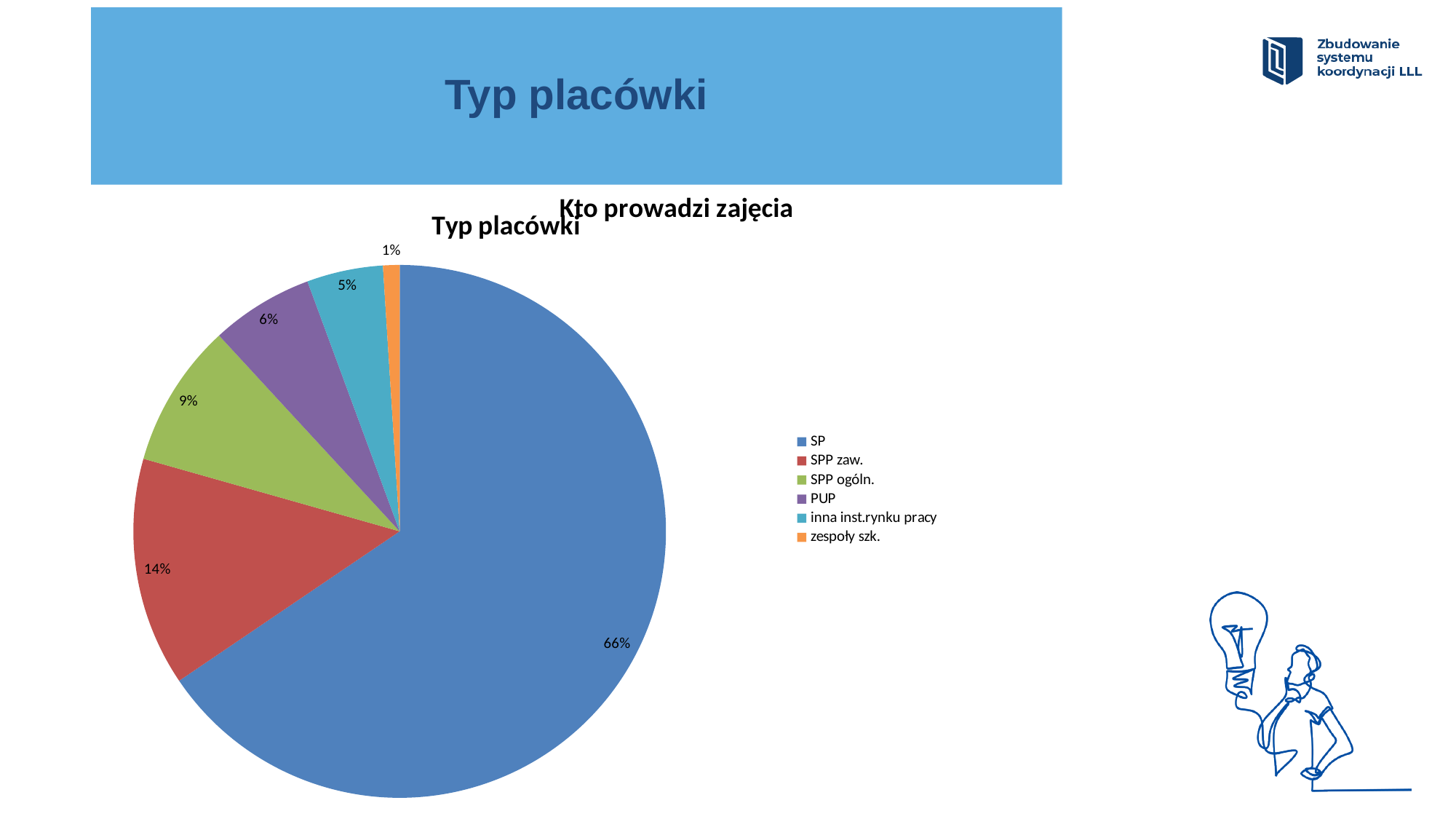
What is the value shown for SPP ogóln.? 9% Which category has the largest slice of the pie? SP What is the value shown for zespoły szk.? 1% What share of the pie does SP account for? 66% What is the value shown for SPP zaw.? 14% How many categories does the legend list? 6 Which is larger, the share for PUP or the share for inna inst.rynku pracy? PUP What is the value shown for inna inst.rynku pracy? 5% What is the difference between the shares of SPP zaw. and SPP ogóln.? 5% Which category has the smallest slice of the pie? zespoły szk. What kind of chart is shown on the slide? pie chart What is the value shown for PUP? 6%